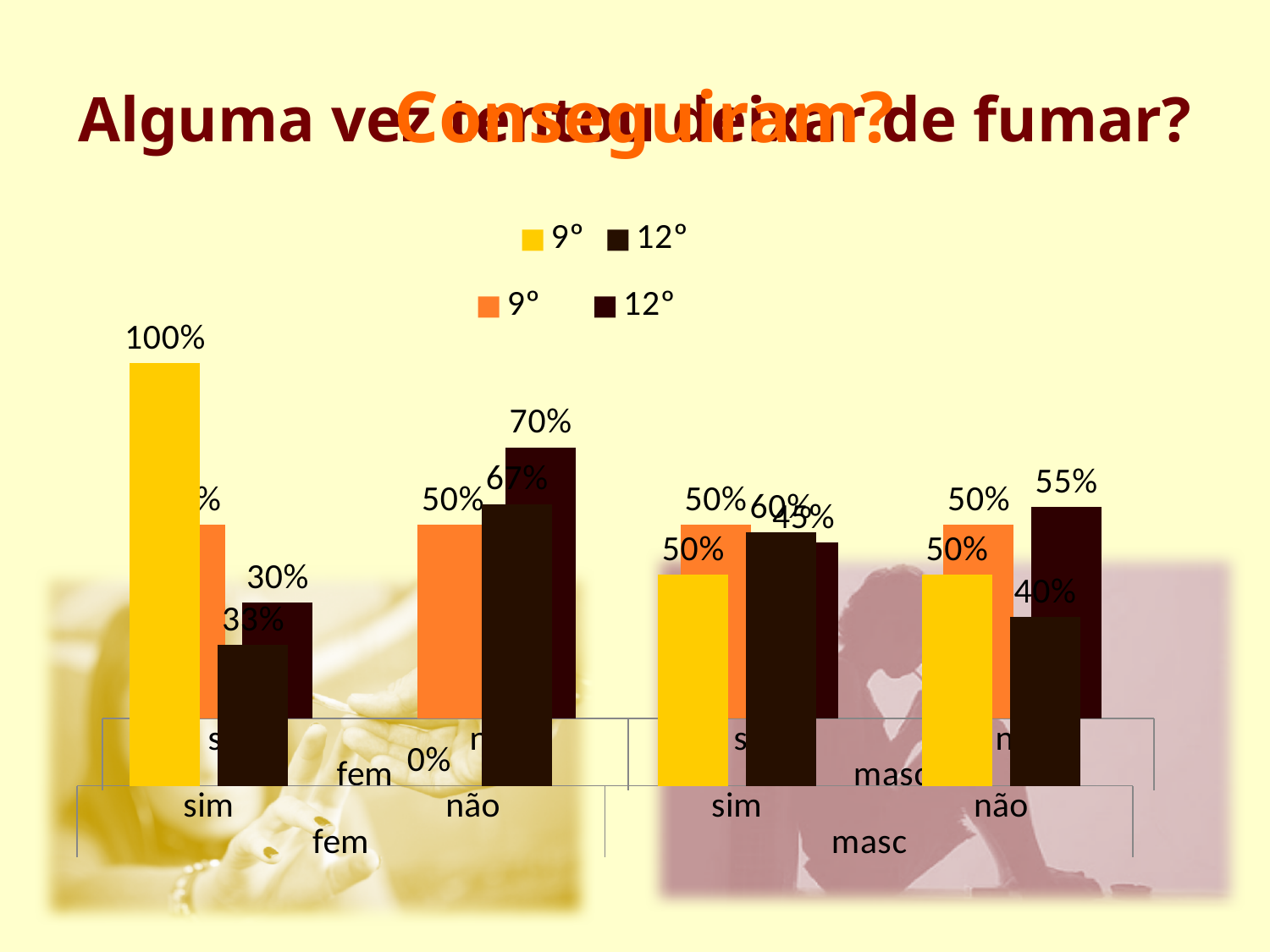
In the chart with orange bars, what is the value for 12° in the 'não' category under 'masc'? 55% In the chart with yellow bars, what is the difference between the 9° and 12° values for 'sim' under 'fem'? 67 percentage points In the chart with yellow bars, what is the value for 12° in the 'sim' category under 'fem'? 33% In the chart with yellow bars, which bar is the highest? 9° for 'sim' under 'fem' (100%) In the chart with yellow bars, which is larger for 'não' under 'masc': 9° or 12°? 9° In the chart with yellow bars, what is the value for 12° in the 'não' category under 'fem'? 67% In the chart with yellow bars, what is the value for 9° in the 'sim' category under 'fem'? 100% In the chart with yellow bars, what is the value for 9° in the 'não' category under 'fem'? 0% In the chart with orange bars, what is the value for 12° in the 'não' category under 'fem'? 70% In the chart with orange bars, what is the value for 12° in the 'sim' category under 'fem'? 30% What kind of chart is used on this slide? Bar chart How many series does the legend of the chart with yellow bars list? 2